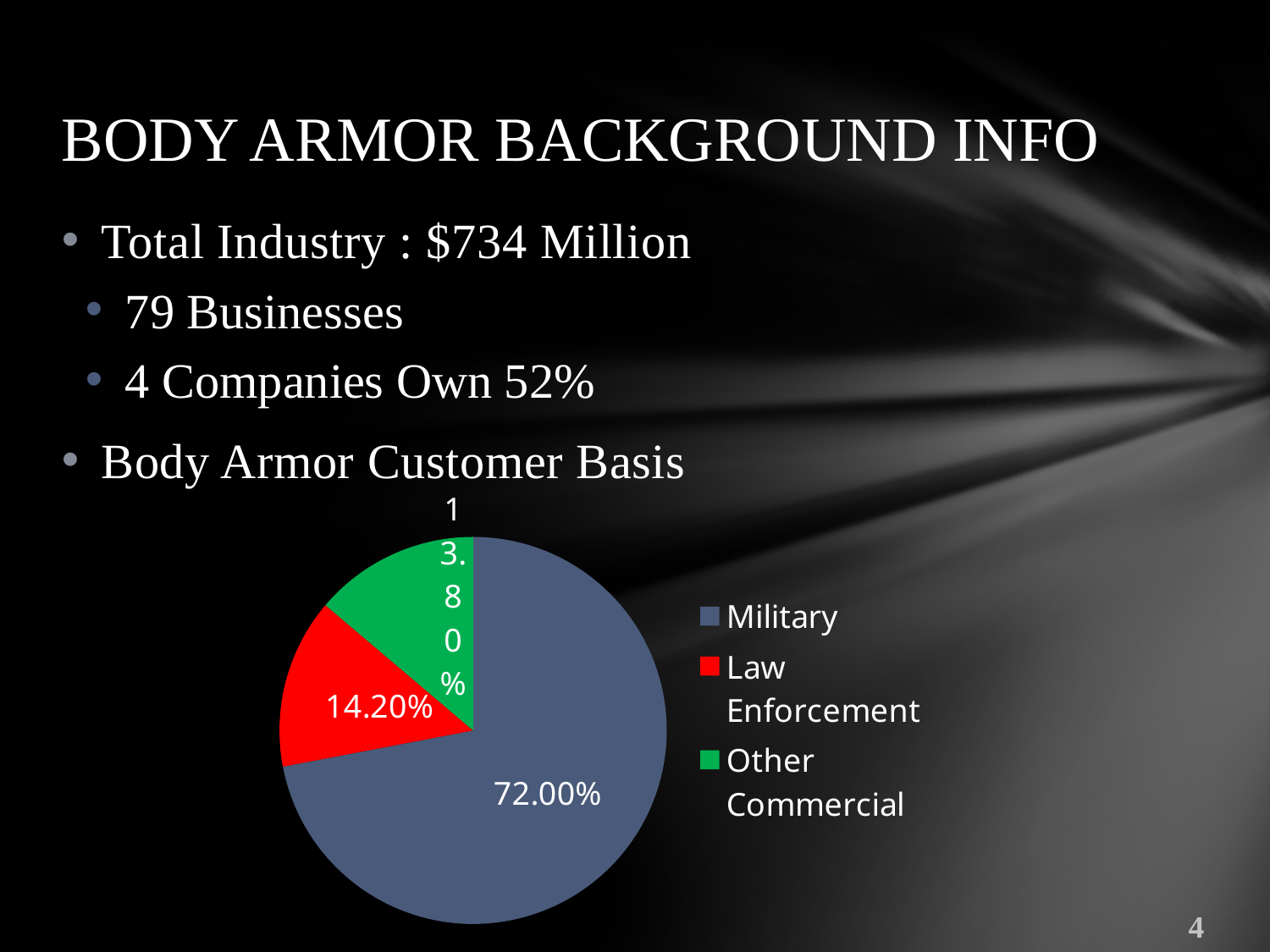
Which category has the largest slice of the pie chart? Military What percentage of the pie chart does Other Commercial account for? 13.80% What kind of chart is shown on the slide? pie chart What percentage of the pie chart does Law Enforcement account for? 14.20% What percentage of the pie chart does Military account for? 72.00% What colour is the Law Enforcement slice in the pie chart? red What colour is the Other Commercial slice in the pie chart? green Which is larger in the pie chart, Military or Other Commercial? Military How many slices does the pie chart have? 3 What is the difference in percentage points between the Military slice and the Law Enforcement slice? 57.80 What is the combined share of Law Enforcement and Other Commercial in the pie chart? 28.00% How many entries does the pie chart legend list? 3